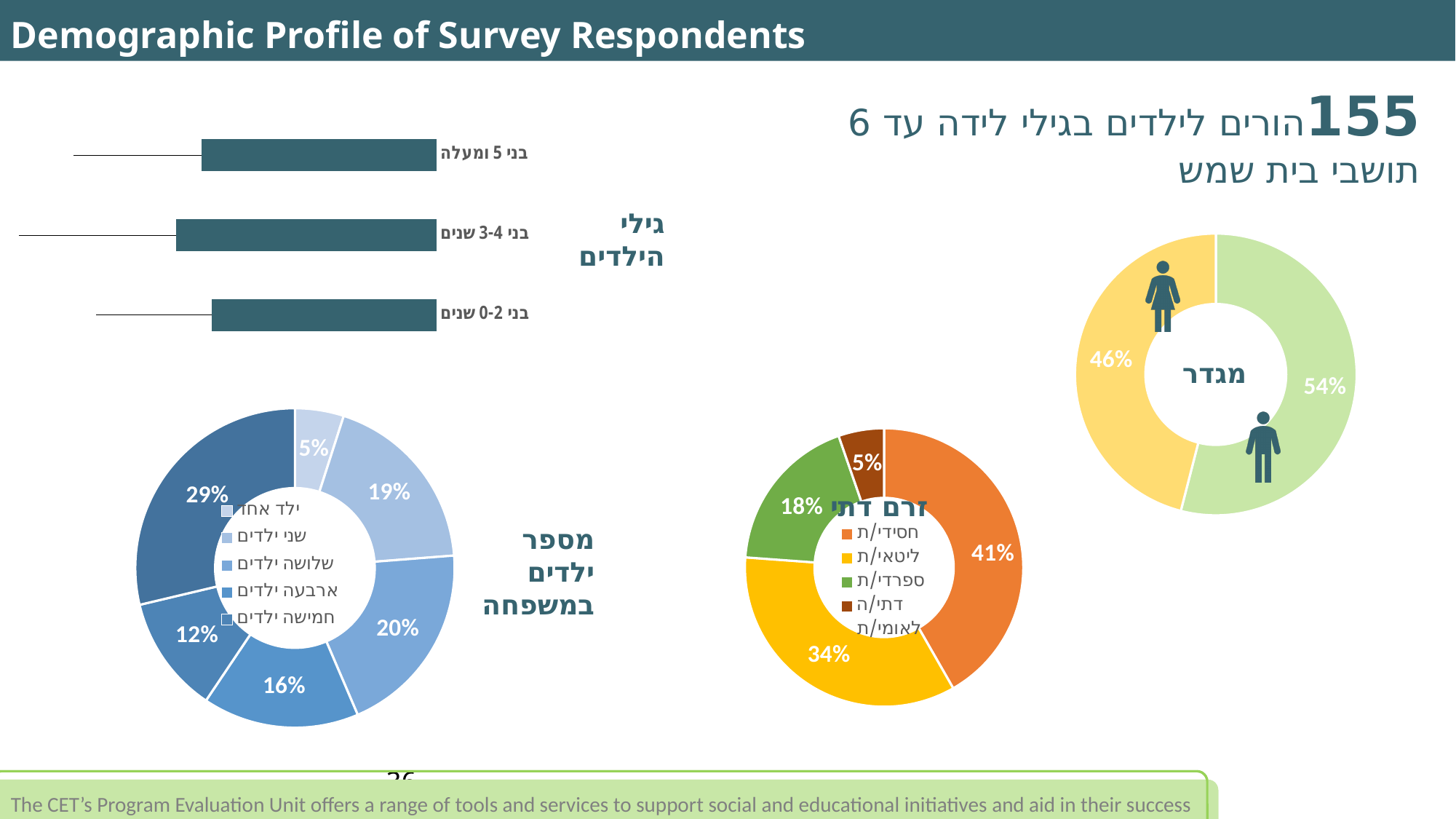
In the 'גילי הילדים' bar chart, which category has the longest bar? בני 3-4 שנים In the 'מספר ילדים במשפחה' donut chart, what is the largest percentage shown? 29% In the 'מגדר' donut chart, which slice is larger, the one with the female icon or the one with the male icon? the one with the male icon How many entries does the legend of the 'זרם דתי' donut chart list? 4 In the 'זרם דתי' donut chart, what percentage is shown for חסידי/ת? 41% In the 'זרם דתי' donut chart, which category has the smallest share? דתי/ה לאומי/ת In the 'מגדר' donut chart, what percentage is shown for the slice with the female icon? 46% In the 'מספר ילדים במשפחה' donut chart, what is the smallest percentage shown? 5% In the 'זרם דתי' donut chart, what is the difference in percentage points between חסידי/ת and ליטאי/ת? 7 How many categories does the 'גילי הילדים' bar chart show? 3 In the 'זרם דתי' donut chart, what percentage is shown for ספרדי/ת? 18% In the 'זרם דתי' donut chart, what percentage is shown for ליטאי/ת? 34%